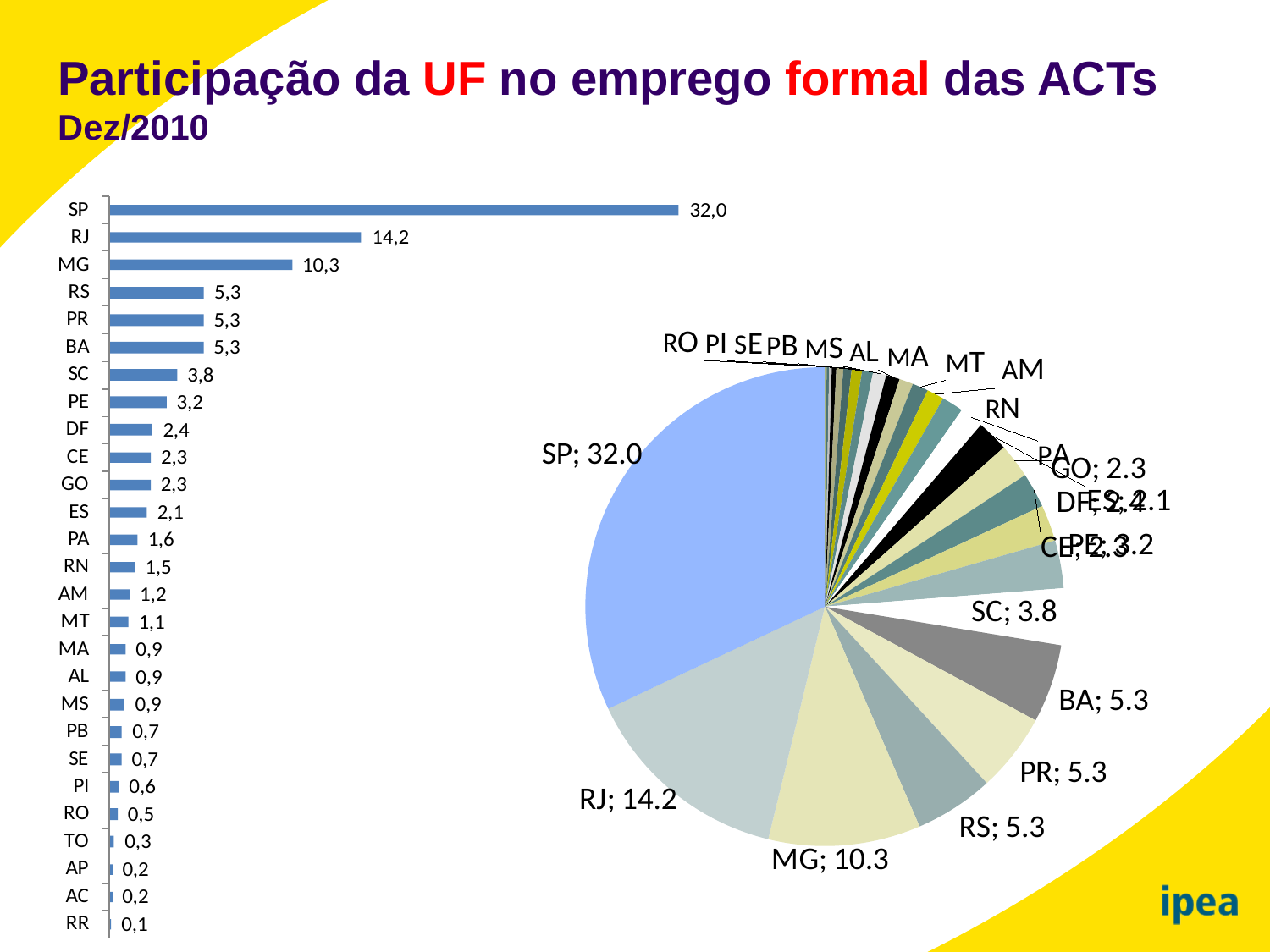
How many UFs are listed in the bar chart on the left? 27 In the bar chart on the left, which UF has the highest value? SP In the bar chart on the left, what is the value for RJ? 14,2 In the bar chart on the left, what is the value for SC? 3,8 In the bar chart on the left, what is the value for SP? 32,0 In the pie chart on the right, what is the value shown for MG? 10.3 In the bar chart on the left, which is larger, the value for SC or the value for PE? SC In the bar chart on the left, what is the difference between the values for MG and RS? 5,0 What kind of chart is the chart on the right of the slide? Pie chart In the bar chart on the left, what is the difference between the values for SP and RJ? 17,8 What kind of chart is the chart on the left of the slide? Bar chart In the bar chart on the left, which UF has the lowest value? RR